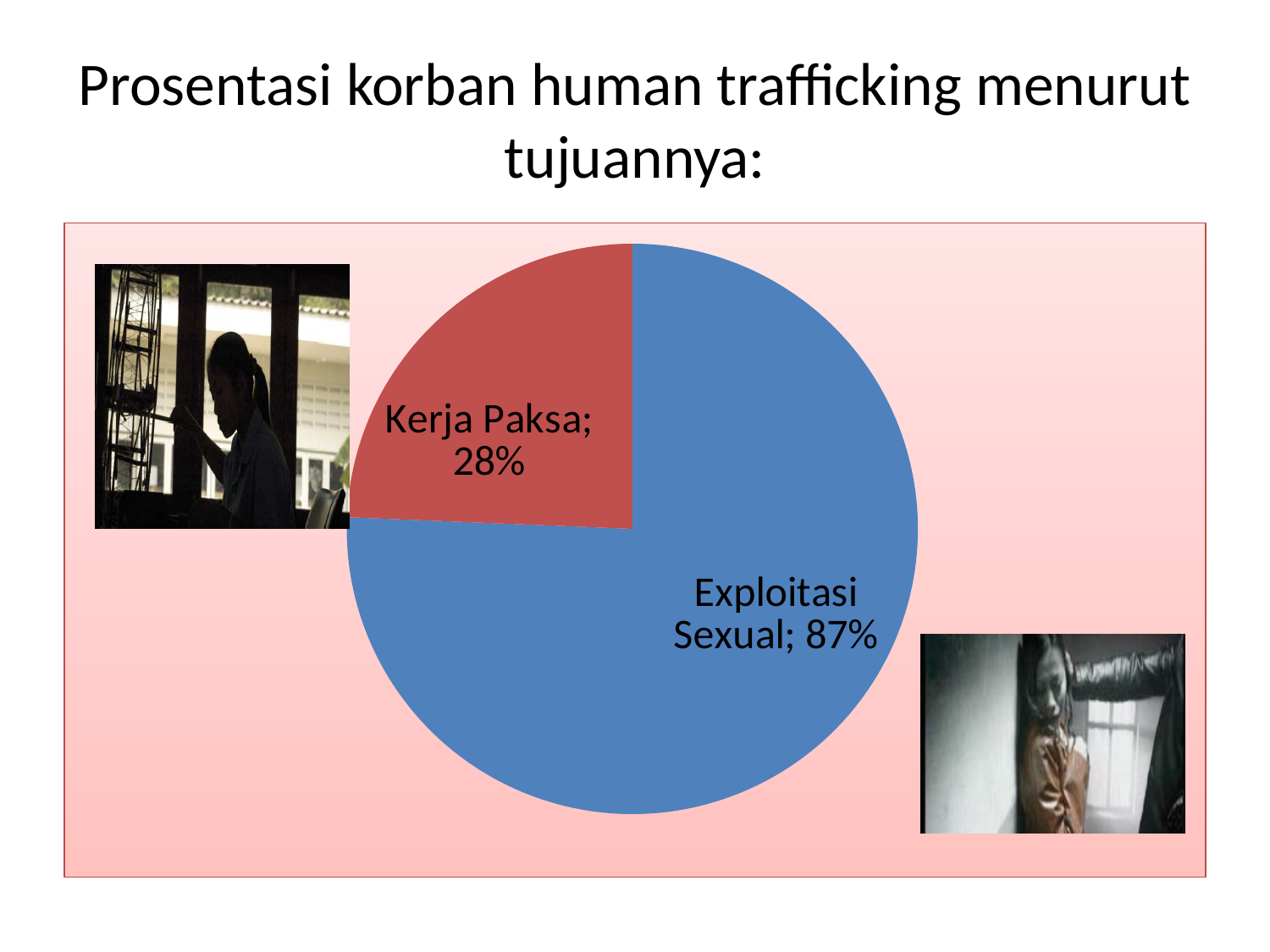
Which category has the largest slice of the pie? Exploitasi Sexual What colour is the Exploitasi Sexual slice? blue What percentage is shown for Exploitasi Sexual? 87% What is the difference in percentage points between the Exploitasi Sexual label and the Kerja Paksa label? 59 What kind of chart is shown on the slide? pie chart What share of the pie is labelled for Kerja Paksa? 28% Which category has the smallest slice of the pie? Kerja Paksa How many slices does the pie chart have? 2 What is the title of the slide containing the pie chart? Prosentasi korban human trafficking menurut tujuannya: What percentage is shown for Kerja Paksa? 28% Which is larger, the slice for Kerja Paksa or the slice for Exploitasi Sexual? Exploitasi Sexual